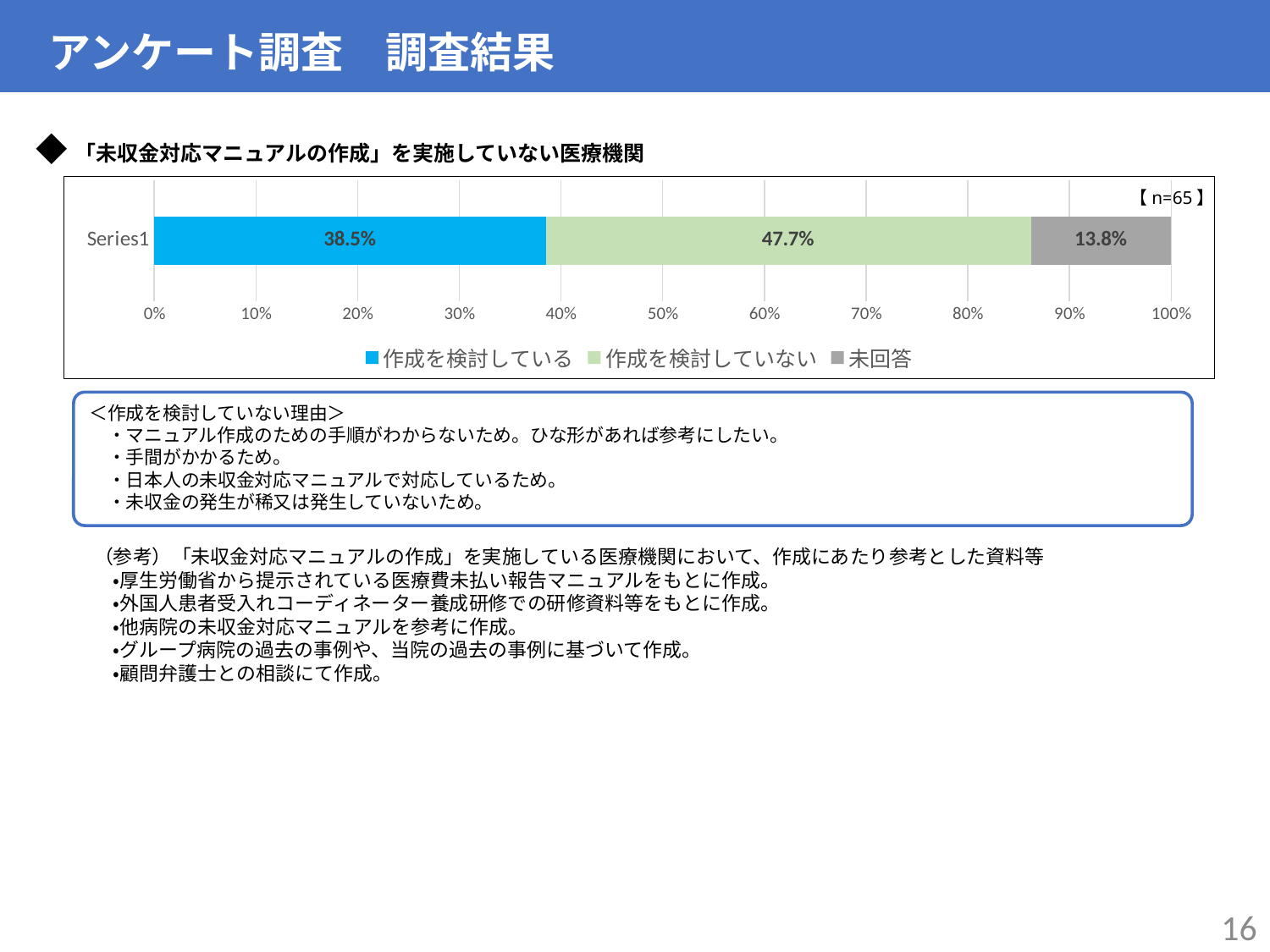
What percentage of respondents answered 作成を検討していない? 47.7% What is the difference in percentage points between 作成を検討していない and 作成を検討している? 9.2 What is the sample size (n) shown on the chart? n=65 Which response category has the largest share? 作成を検討していない What is the total of the three segments in the stacked bar? 100% Is the value for 作成を検討している greater or less than 40%? less What percentage of respondents answered 作成を検討している? 38.5% Which response category has the smallest share? 未回答 What kind of chart is shown on the slide? Stacked bar chart How many series does the legend list? 3 Which is larger, the share for 作成を検討している or the share for 未回答? 作成を検討している What percentage of respondents answered 未回答? 13.8%